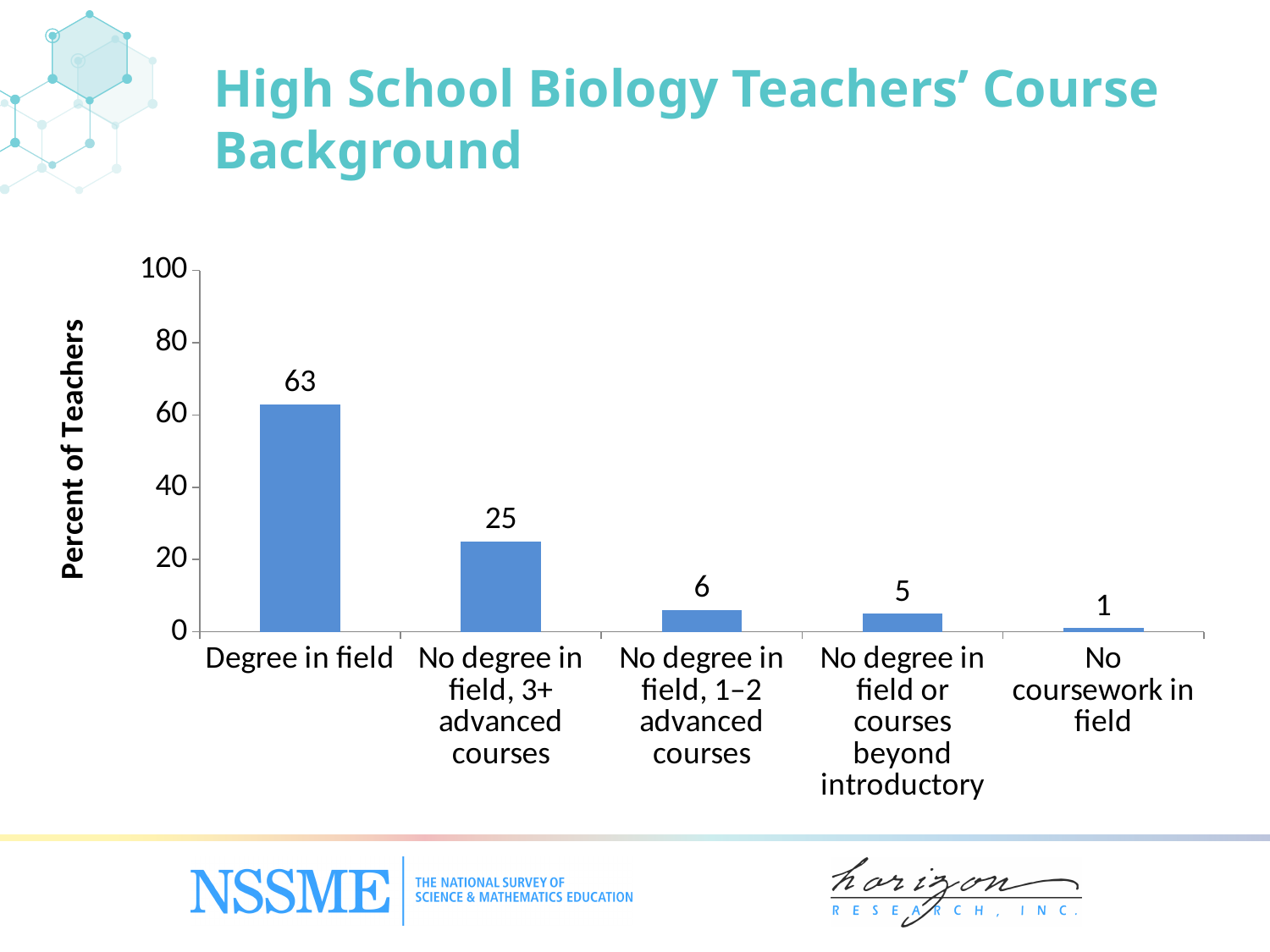
What is the value for 'No degree in field, 1–2 advanced courses'? 6 Is the value for 'Degree in field' greater or less than 60? greater What is the label of the y axis? Percent of Teachers Which category has the highest percent of teachers? Degree in field Which category has the lowest percent of teachers? No coursework in field What percent of teachers have a degree in field? 63 What is the value for 'No coursework in field'? 1 How many categories are shown on the x axis? 5 Which is larger: 'No degree in field, 1–2 advanced courses' or 'No degree in field or courses beyond introductory'? No degree in field, 1–2 advanced courses What is the value for 'No degree in field, 3+ advanced courses'? 25 What is the difference between 'Degree in field' and 'No degree in field, 3+ advanced courses'? 38 What kind of chart is shown on the slide? Bar chart